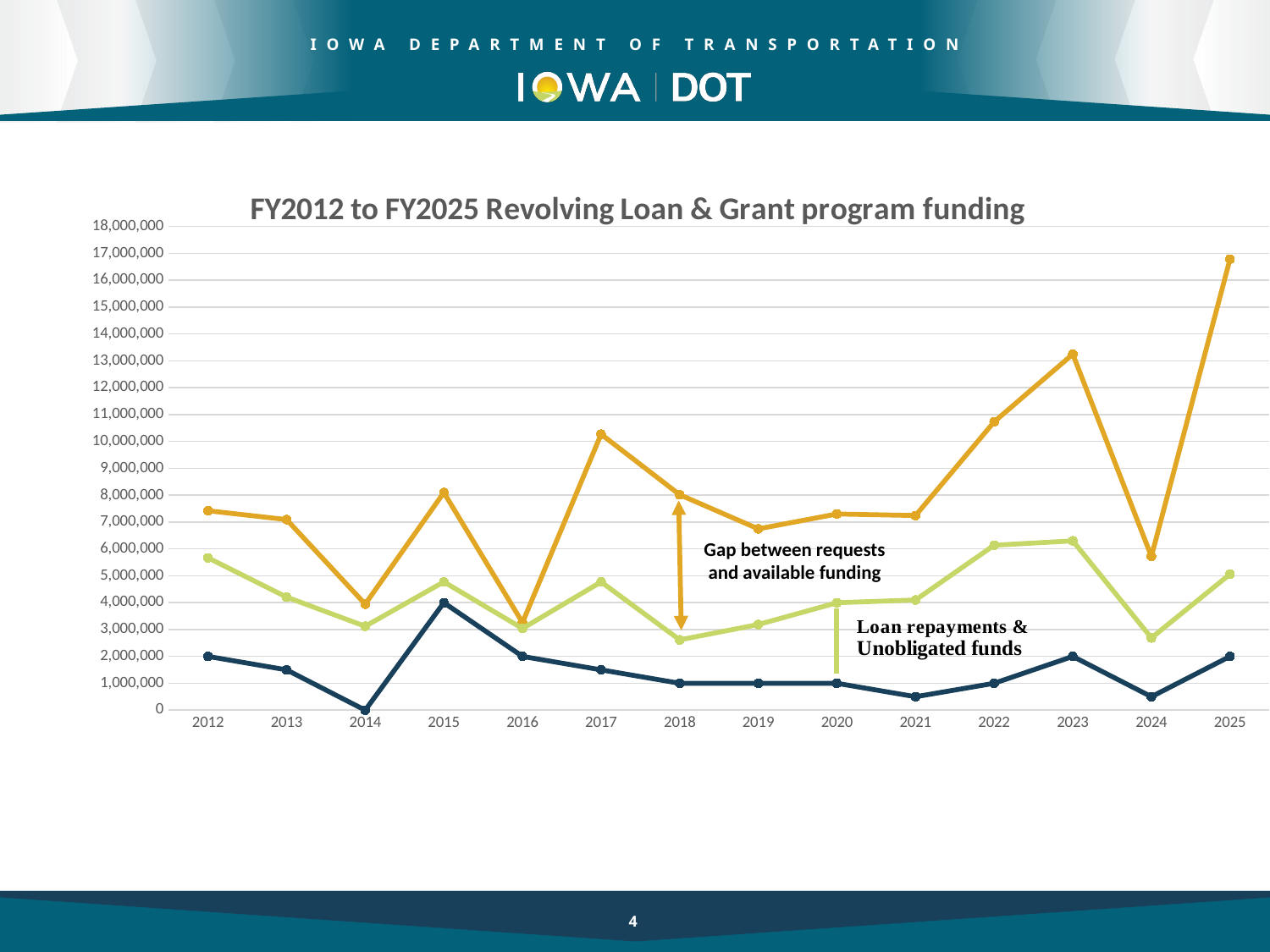
Is the value of the orange line in 2024 greater or less than 7,000,000? less In which year does the dark blue line reach its highest value? 2015 Which year has the larger value on the orange line, 2022 or 2023? 2023 Is the value of the orange line in 2025 greater or less than 16,000,000? greater How many years are plotted along the x axis of the chart? 14 Is the value of the light green line in 2023 greater or less than 5,000,000? greater In which year does the orange line reach its lowest value? 2016 Does the orange line rise or fall from 2024 to 2025? rise What kind of chart is shown on the slide? line chart In which year does the orange line reach its highest value? 2025 What is the title of the chart? FY2012 to FY2025 Revolving Loan & Grant program funding